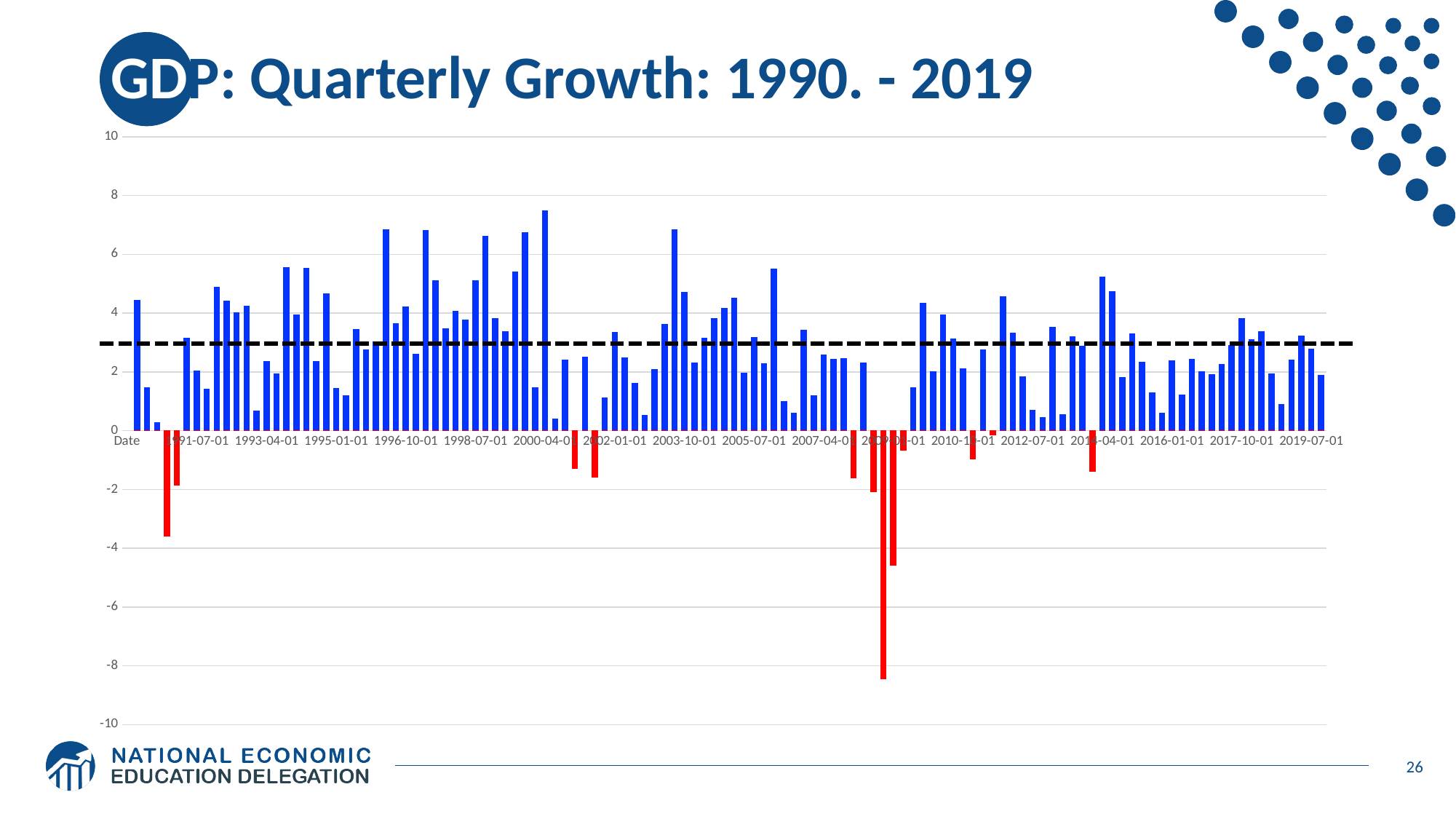
Is the tallest bar on the chart located before or after the 2002-01-01 label on the horizontal axis? before Is the tallest bar on the chart greater or less than 6? greater Is the lowest bar on the chart (the deepest negative quarter) greater or less than -8? less What kind of chart is shown on the slide? bar chart What is the last date label shown on the horizontal axis? 2019-07-01 What is the lowest value shown on the vertical axis? -10 What is the highest value shown on the vertical axis? 10 What colour are the bars that show negative quarterly growth? red Is the deepest negative bar on the chart located closer to the 2009-01-01 label or the 1991-07-01 label? 2009-01-01 What is the title of the chart? GDP: Quarterly Growth: 1990. - 2019